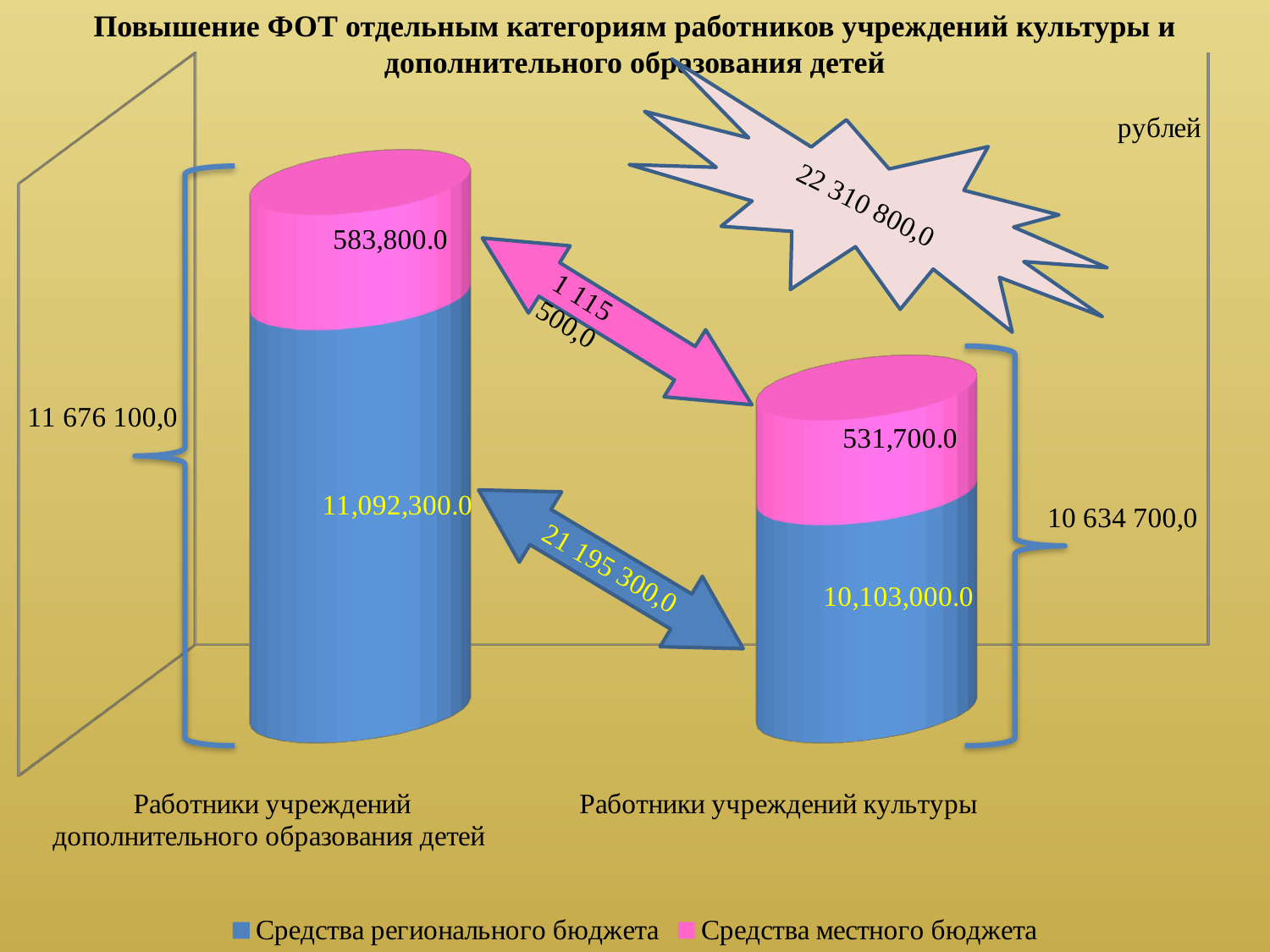
What is the difference between the 'Средства регионального бюджета' values for the two categories? 989,300.0 Which colour represents 'Средства местного бюджета' in the chart? Pink Which category has the higher value for 'Средства регионального бюджета'? Работники учреждений дополнительного образования детей How many categories are shown on the x axis of the chart? 2 What is the value of 'Средства местного бюджета' for 'Работники учреждений культуры'? 531,700.0 What is the value of 'Средства регионального бюджета' for 'Работники учреждений культуры'? 10,103,000.0 Which category has the lower value for 'Средства местного бюджета'? Работники учреждений культуры What type of chart is shown on the slide? Stacked bar chart What is the total of the stacked bar for 'Работники учреждений культуры'? 10 634 700,0 What is the value of 'Средства местного бюджета' for 'Работники учреждений дополнительного образования детей'? 583,800.0 How many series does the chart legend list? 2 What is the value of 'Средства регионального бюджета' for 'Работники учреждений дополнительного образования детей'? 11,092,300.0